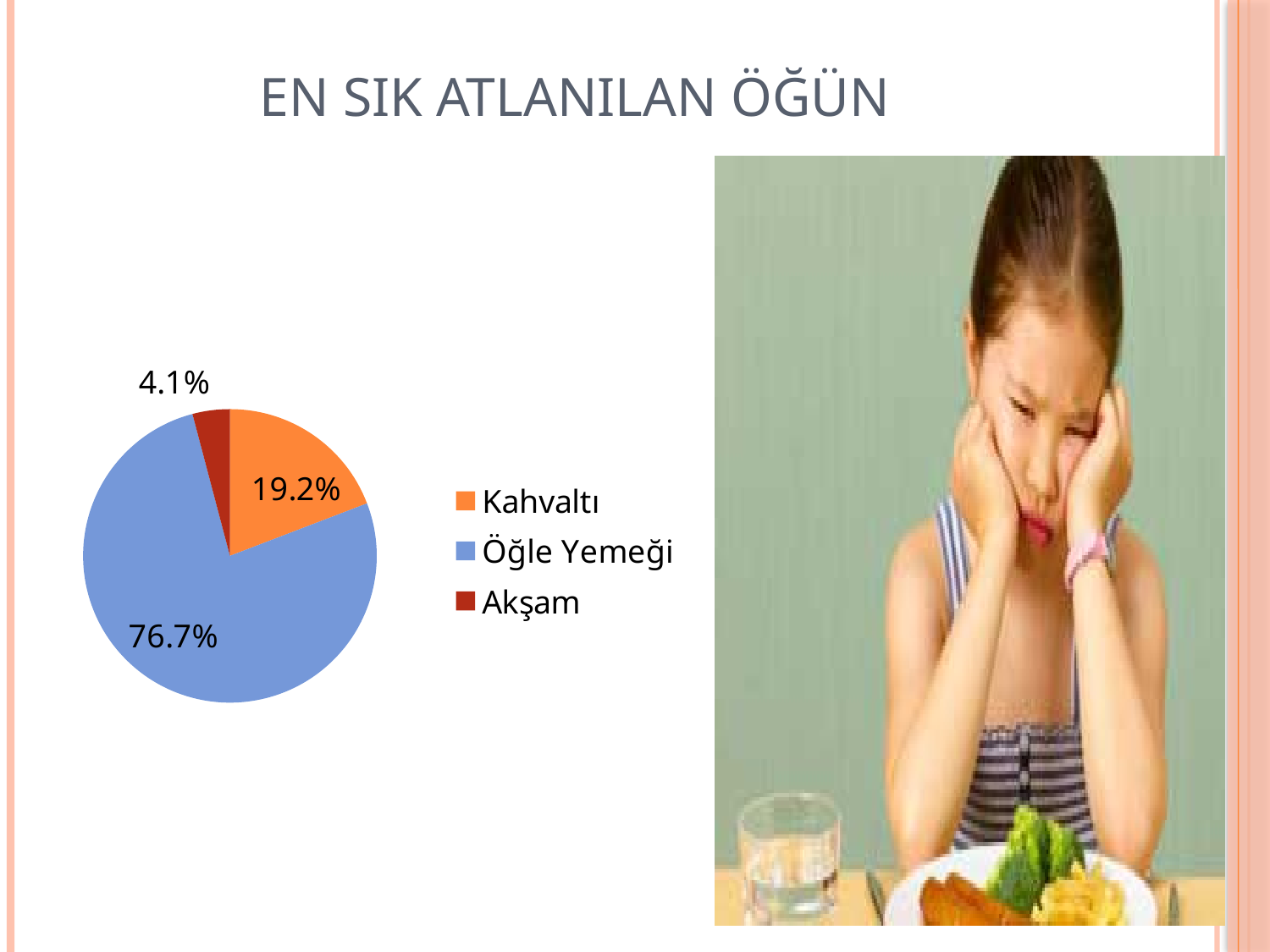
How many categories does the pie chart have? 3 What is the difference between the shares of Kahvaltı and Akşam? 15.1% Which is larger, the share for Kahvaltı or the share for Akşam? Kahvaltı What kind of chart is shown on the slide? pie chart What is the difference between the shares of Öğle Yemeği and Kahvaltı? 57.5% Which category has the smallest slice of the pie? Akşam What share of the pie does Akşam have? 4.1% What share of the pie does Öğle Yemeği have? 76.7% Which colour represents Öğle Yemeği in the pie chart? blue What is the title of the slide containing the chart? EN SIK ATLANILAN ÖĞÜN What share of the pie does Kahvaltı have? 19.2% Which category has the largest slice of the pie? Öğle Yemeği